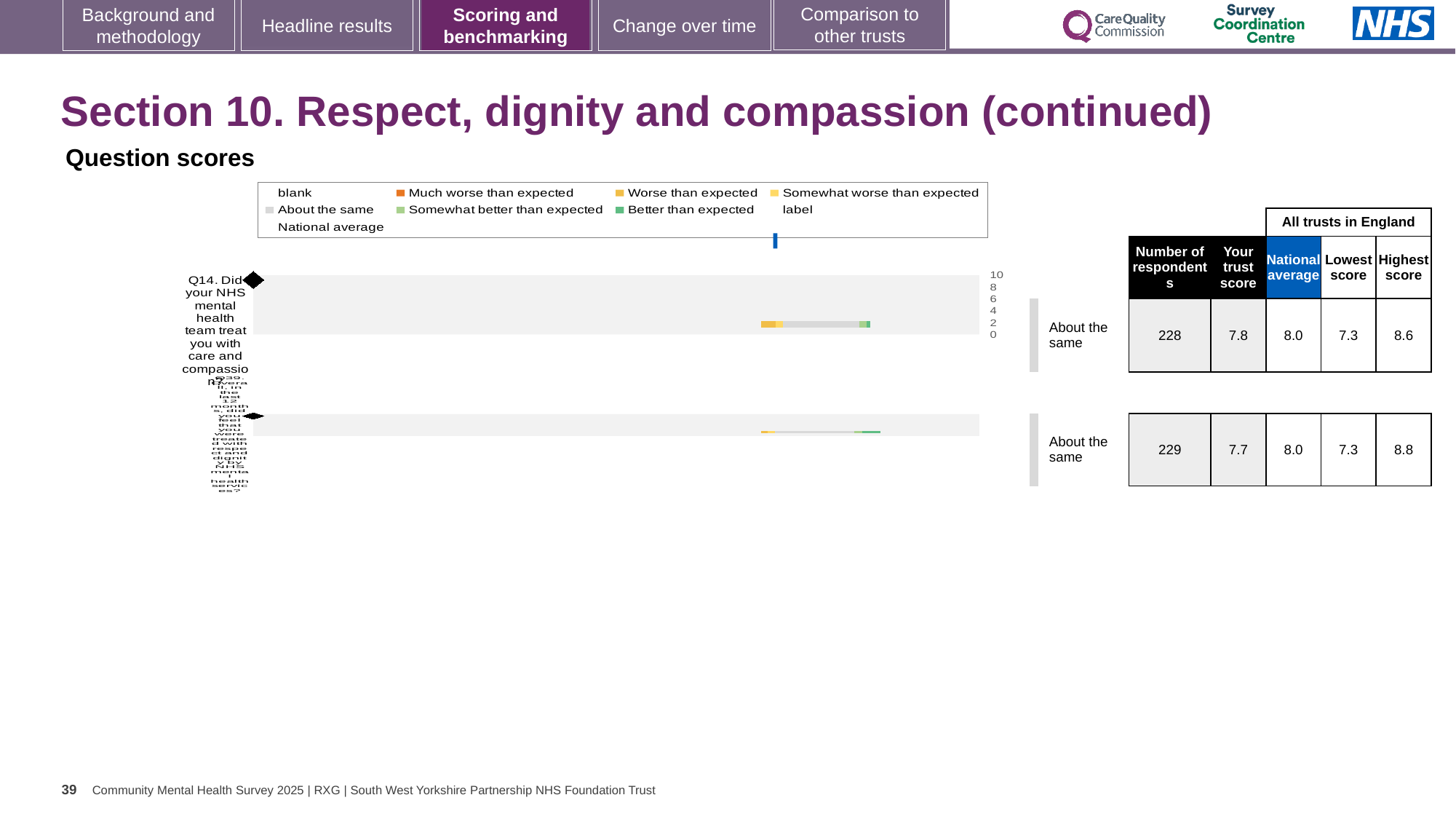
How many questions are plotted in the Question scores chart? 2 Which question has the higher trust score, Q14 or Q39? Q14 In the table beside the chart, what is the highest score across all trusts in England for Q39? 8.8 What kind of chart is shown under 'Question scores'? bar chart In the table beside the chart, what is 'Your trust score' for Q39? 7.7 In the table beside the chart, what is 'Your trust score' for Q14? 7.8 What colour does the chart legend use for 'Much worse than expected'? orange What benchmark category is shown next to the chart for Q14? About the same What is the difference between the highest score and the lowest score for Q14? 1.3 How much higher is the national average than the trust score for Q39? 0.3 In the table beside the chart, what is the national average for Q14? 8.0 In the table beside the chart, what is the number of respondents for Q14? 228